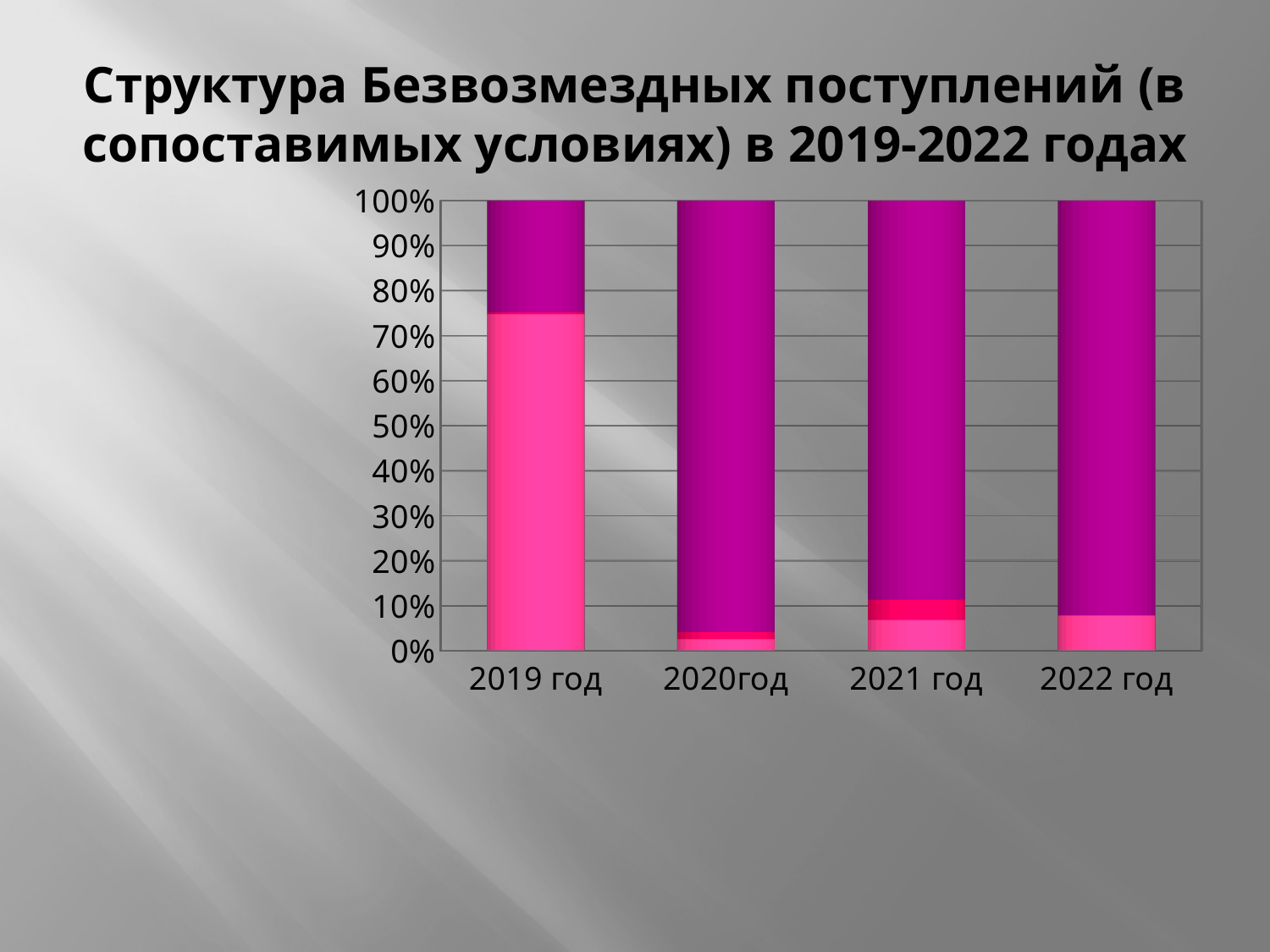
What kind of chart is shown on the slide? Stacked bar chart Which year has the largest bottom (pink) segment in the chart? 2019 год Is the top (purple) segment for 2019 год greater or less than 30%? less Which year has the smallest bottom (pink) segment in the chart? 2020год Is the top (purple) segment for 2022 год greater or less than 90%? greater Is the bottom (pink) segment larger for 2019 год or for 2022 год? 2019 год Is the top (purple) segment larger for 2019 год or for 2020год? 2020год What is the range of the y axis of the chart? 0% to 100% Is the bottom (pink) segment for 2019 год greater or less than 70%? greater How many years (bars) are shown on the x axis of the chart? 4 What is the title of the chart on the slide? Структура Безвозмездных поступлений (в сопоставимых условиях) в 2019-2022 годах